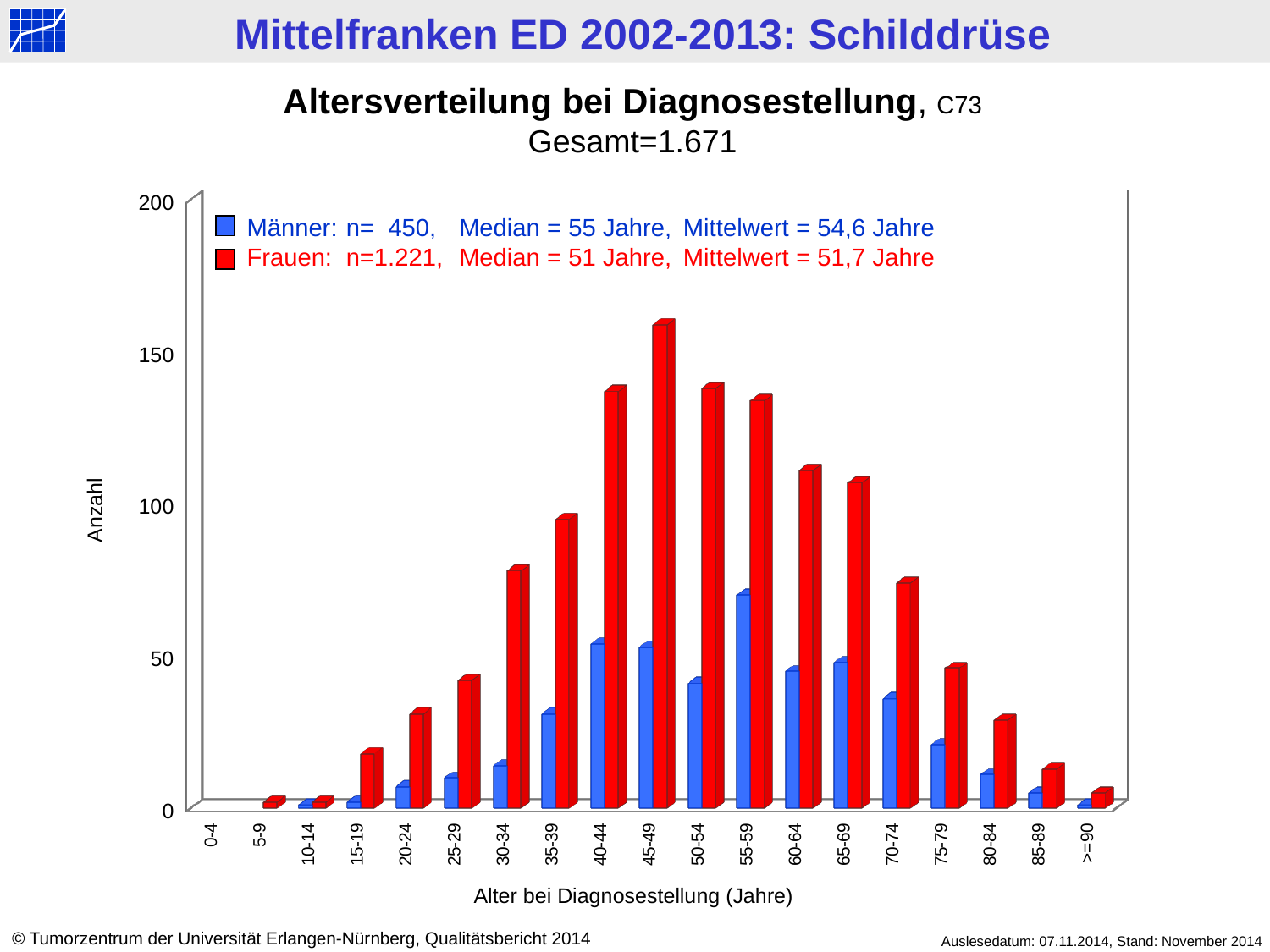
In the 45-49 age group, which series has the larger value, Männer or Frauen? Frauen How many series does the legend list? 2 Which age group has the highest value for Frauen? 45-49 Is the value for Frauen in the 60-64 age group greater or less than 100? greater According to the legend, what is the median age for Männer? 55 Jahre Which age group has the highest value for Männer? 55-59 According to the legend, what is n for Frauen? 1.221 Is the value for Männer in the 55-59 age group greater or less than 50? greater How many age groups are shown on the x axis? 19 What kind of chart is shown on the slide? bar chart Is the value for Frauen in the 35-39 age group greater or less than 100? less